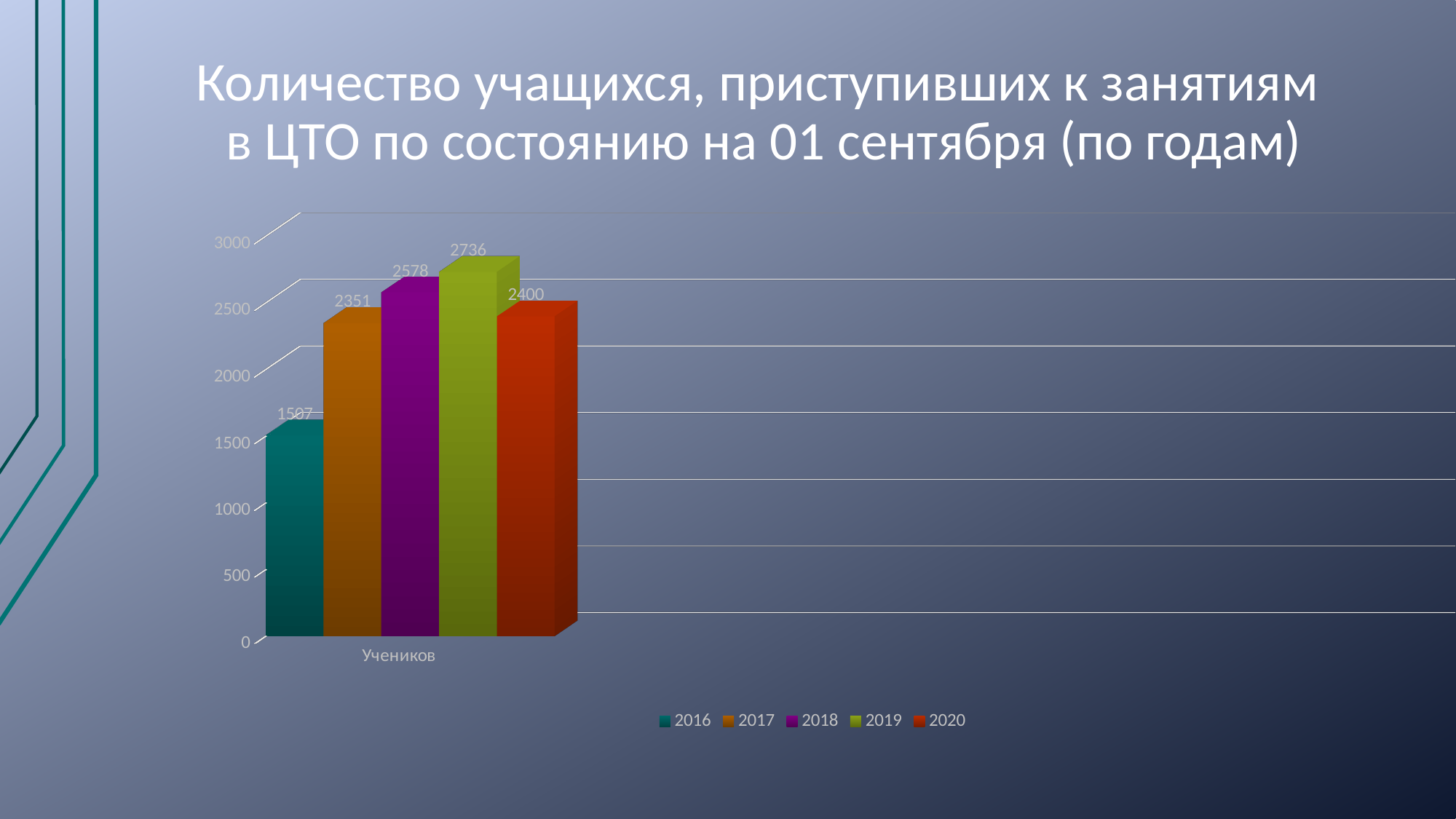
Is the value for 2017 greater or less than 2000? greater What is the value for 2019? 2736 What kind of chart is shown on the slide? bar chart What is the difference between the values for 2019 and 2020? 336 Which year has the highest value? 2019 Which is larger, the value for 2018 or the value for 2020? 2018 What is the value for 2016? 1507 What is the value for 2020? 2400 Which year has the lowest value? 2016 What is the label of the category on the x axis? Учеников What is the difference between the values for 2017 and 2016? 844 How many series does the legend list? 5